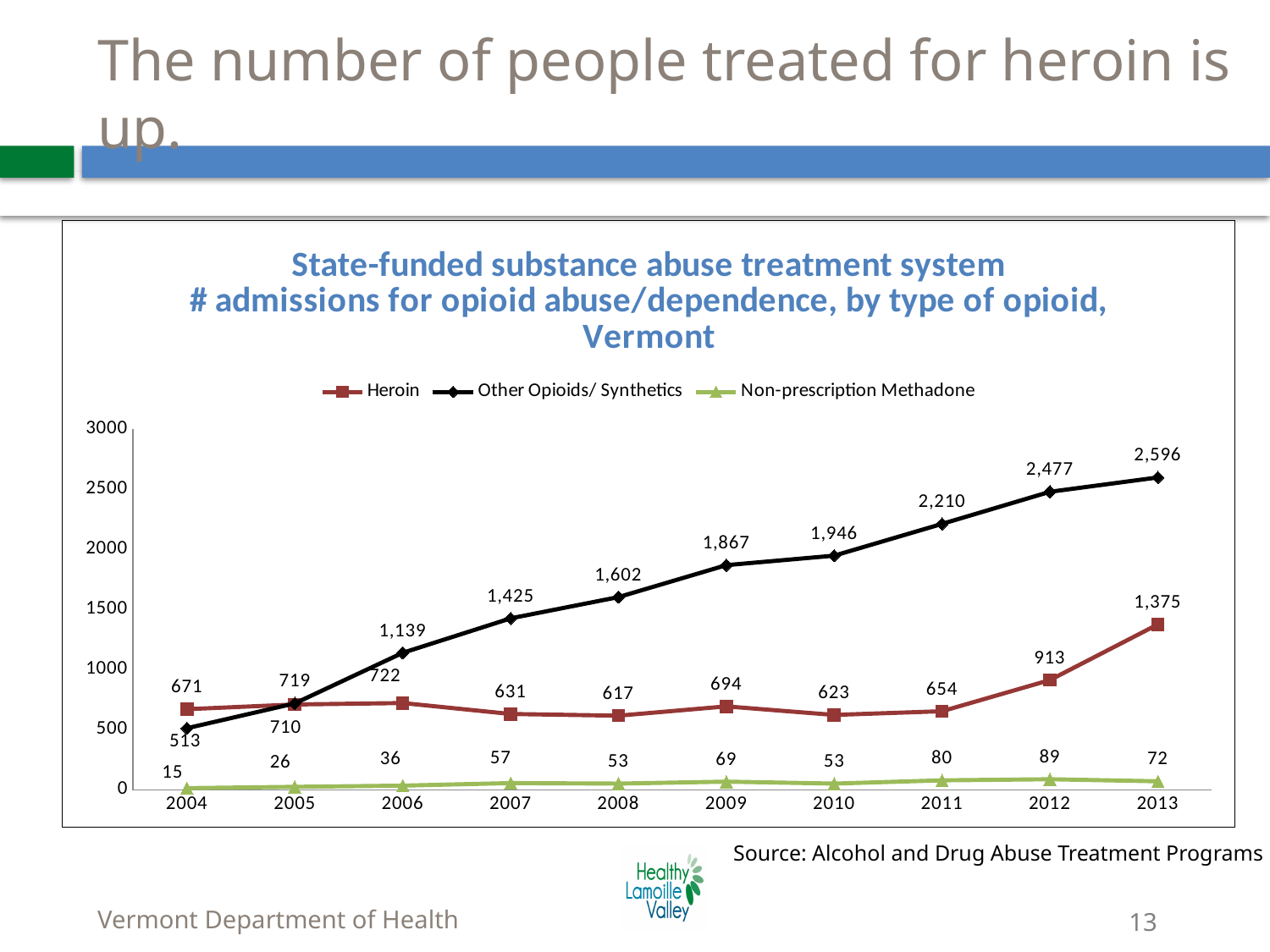
What kind of chart is shown on the slide? Line chart What is the number of heroin admissions in 2013? 1,375 In which year is the Other Opioids/ Synthetics series highest? 2013 In which year is the Non-prescription Methadone series lowest? 2004 How many series does the legend list? 3 What is the difference between the Heroin value in 2013 and in 2012? 462 Does the Other Opioids/ Synthetics series rise or fall from 2004 to 2013? Rise What is the difference between the Other Opioids/ Synthetics value in 2013 and in 2012? 119 How many years are shown on the x axis? 10 Which series has the larger value in 2004, Heroin or Other Opioids/ Synthetics? Heroin What is the value for Non-prescription Methadone in 2011? 80 What is the value for Other Opioids/ Synthetics in 2009? 1,867